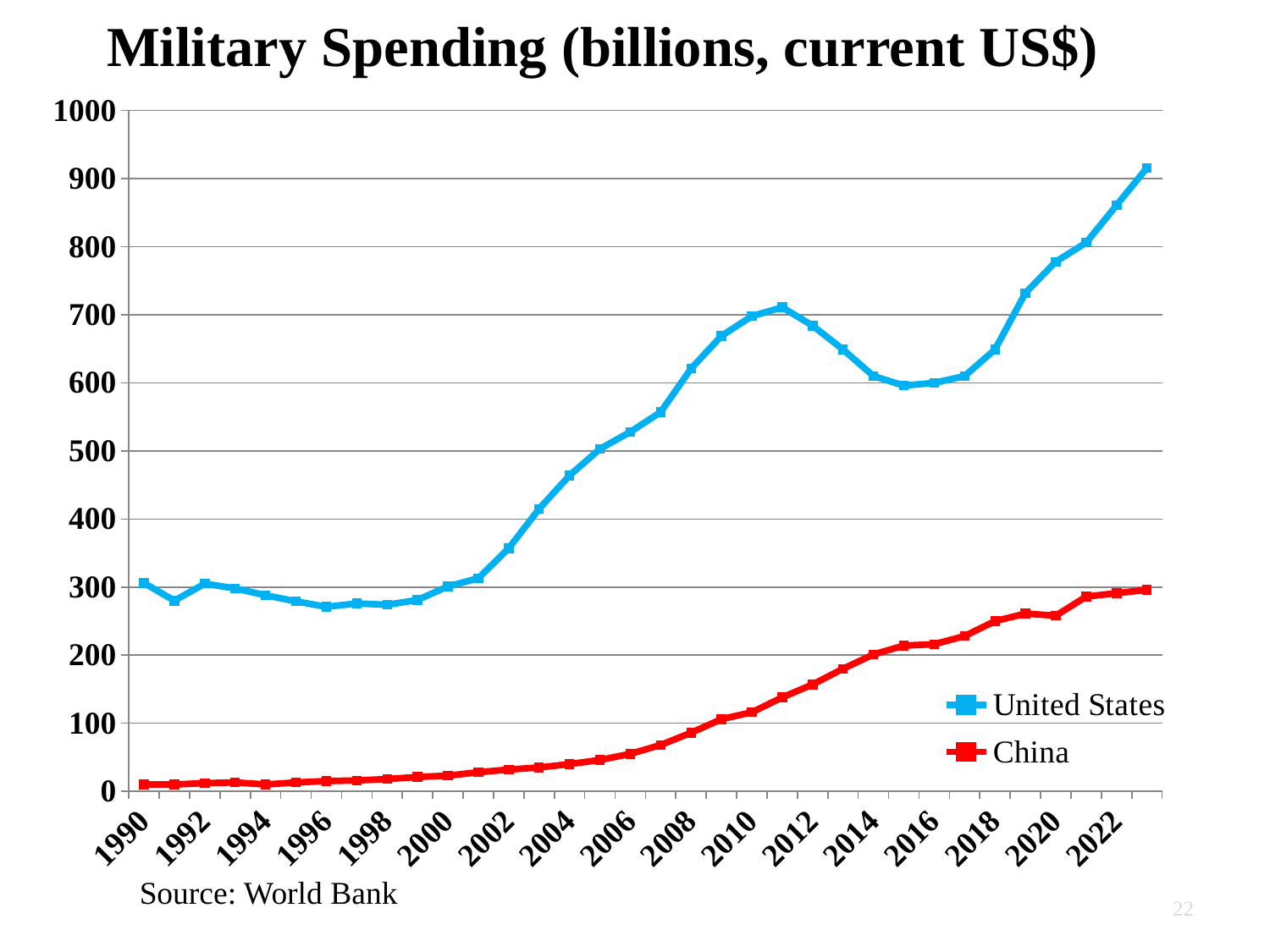
What kind of chart is shown on the slide? Line chart Which series is drawn in red? China In which year does the United States series reach its highest value? 2023 How many series does the legend list? 2 Is the value for the United States in 1996 greater or less than 300? less Is the value for the United States in 2023 greater or less than 800? greater Is the value for the United States in 2010 greater or less than 600? greater Which series has the highest value in 2023? United States Which is larger in 2020, the value for the United States or the value for China? United States What is the title of the chart? Military Spending (billions, current US$) Does the China series generally rise or fall from 1990 to 2023? rise